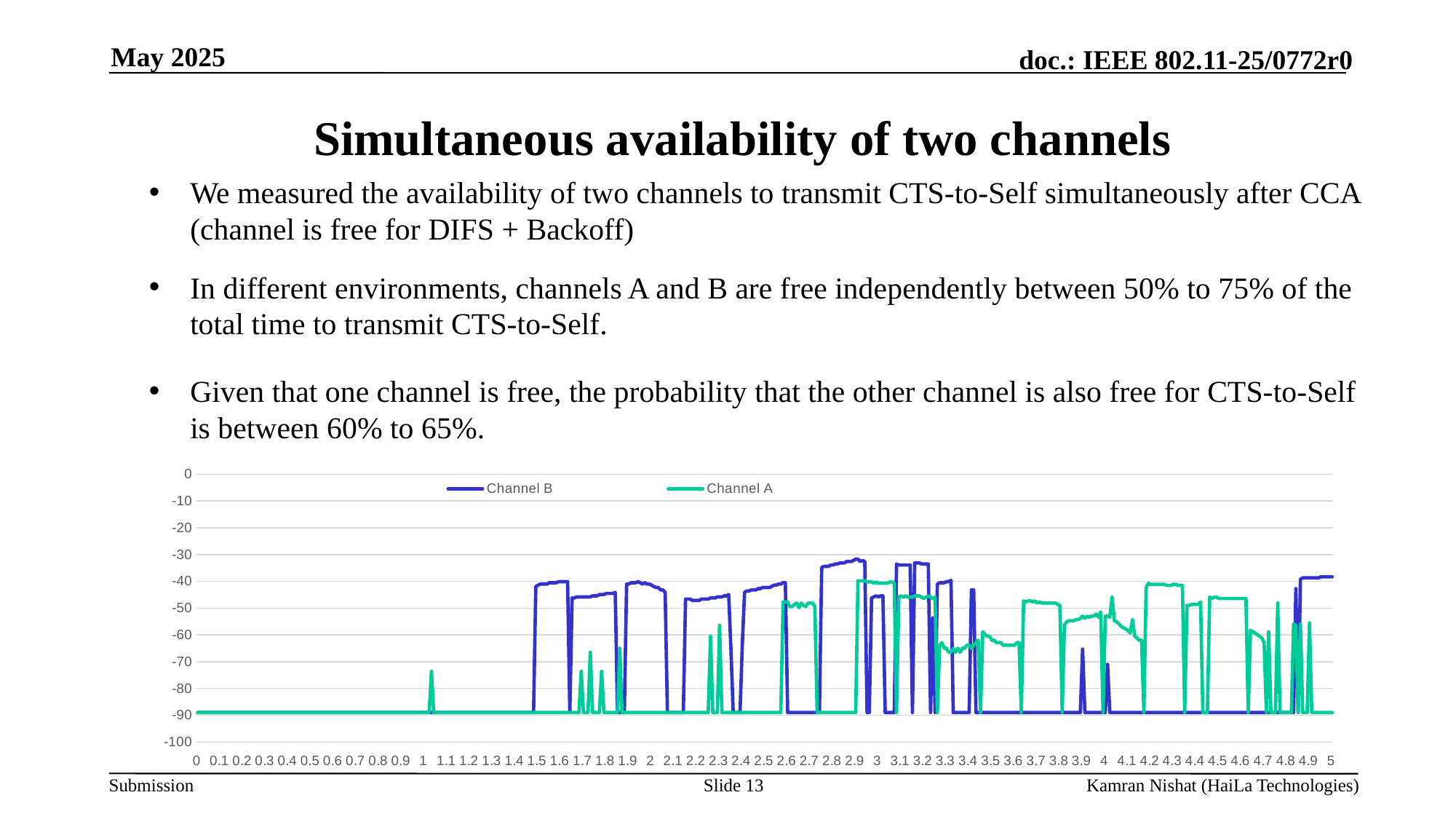
Which colour is used for the Channel A line in the chart? green Is the value of Channel B at x = 2.9 greater or less than -40? greater Is the value of Channel B at x = 3.6 greater or less than -80? less Is the value of Channel A at x = 0.5 greater or less than -80? less At x = 2.9, which series has the higher value, Channel A or Channel B? Channel B What are the two series named in the chart legend? Channel B and Channel A What kind of chart is shown on the slide? line chart At x = 3.6, which series has the higher value, Channel A or Channel B? Channel A At x = 1.5, which series has the higher value, Channel A or Channel B? Channel B How many series does the chart legend list? 2